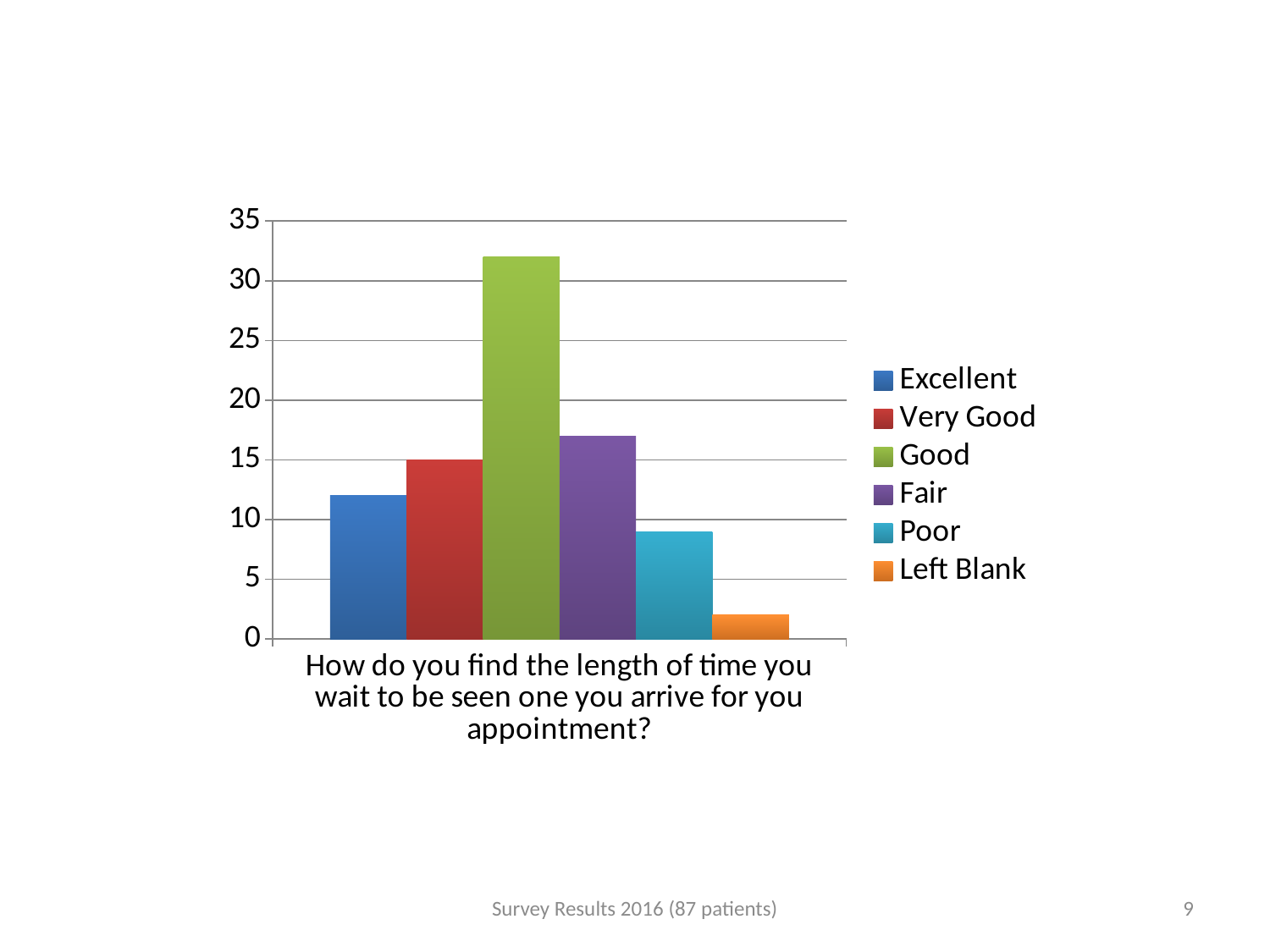
Which response category has the highest bar? Good Which is larger, the value for Very Good or the value for Poor? Very Good What kind of chart is shown on the slide? bar chart What colour is the bar for Good? green How many series does the legend list? 6 Is the value for Good greater or less than 30? greater Which is larger, the value for Fair or the value for Excellent? Fair Is the value for Left Blank greater or less than 5? less Is the value for Poor greater or less than 10? less What is the value for Very Good? 15 Which response category has the lowest bar? Left Blank